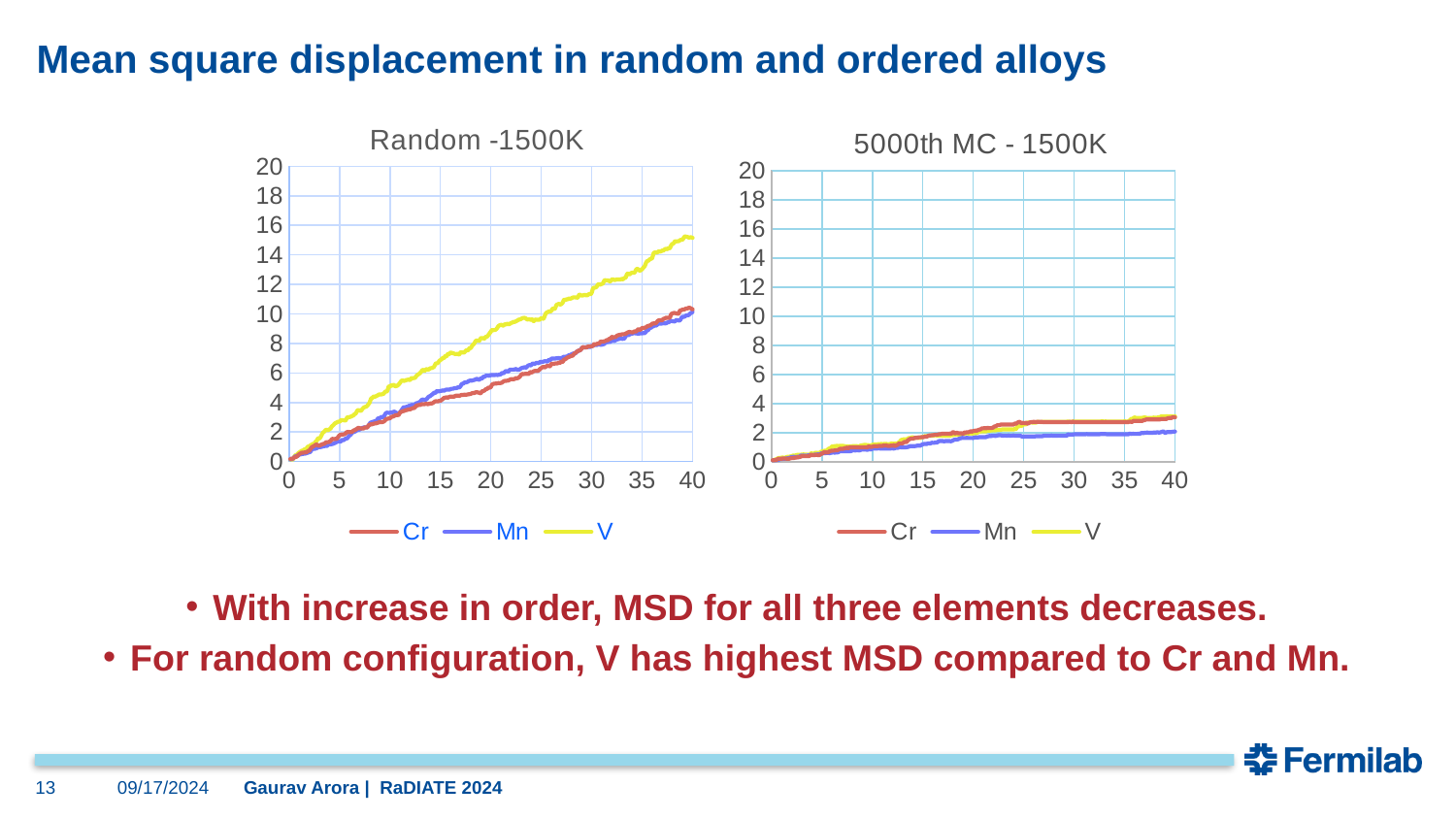
In the 'Random -1500K' chart, do the values of V rise or fall as x increases? rise What kind of chart is the 'Random -1500K' chart? line chart How many series does the legend of the '5000th MC - 1500K' chart list? 3 In the 'Random -1500K' chart, is the value of V at x = 40 greater or less than 14? greater What are the legend entries of the 'Random -1500K' chart? Cr, Mn, V What is the title of the chart on the right? 5000th MC - 1500K In the '5000th MC - 1500K' chart, which series has the lowest value at x = 40? Mn In the 'Random -1500K' chart, is the value of Mn at x = 20 greater or less than 4? greater In the 'Random -1500K' chart, is the value of Cr at x = 40 greater or less than 12? less Is the value of V at x = 40 larger in the 'Random -1500K' chart or in the '5000th MC - 1500K' chart? Random -1500K In the 'Random -1500K' chart, which series has the highest value at x = 40? V